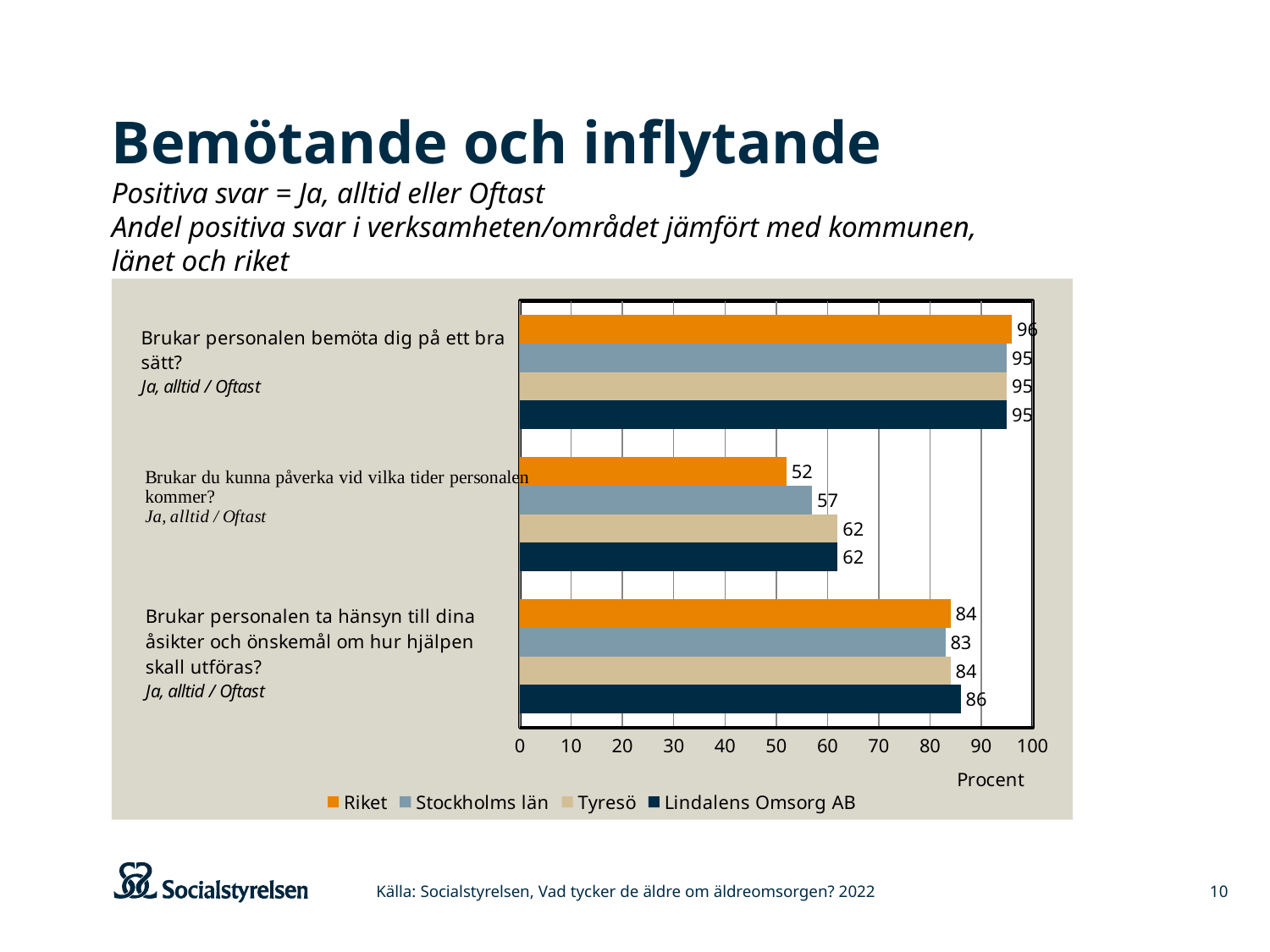
What is the value for Stockholms län on the question 'Brukar personalen bemöta dig på ett bra sätt?' 95 What kind of chart is shown on the slide? Bar chart What is the value for Riket on the question 'Brukar du kunna påverka vid vilka tider personalen kommer?' 52 What is the difference between Lindalens Omsorg AB and Riket on the question 'Brukar du kunna påverka vid vilka tider personalen kommer?' 10 Which series has the lowest value on the question 'Brukar du kunna påverka vid vilka tider personalen kommer?' Riket What is the label on the x axis of the chart? Procent What is the value for Tyresö on the question 'Brukar du kunna påverka vid vilka tider personalen kommer?' 62 Which is larger on the question 'Brukar personalen ta hänsyn till dina åsikter och önskemål om hur hjälpen skall utföras?': Lindalens Omsorg AB or Stockholms län? Lindalens Omsorg AB Is the value for Stockholms län on the question 'Brukar du kunna påverka vid vilka tider personalen kommer?' greater or less than 60? less What is the value for Lindalens Omsorg AB on the question 'Brukar personalen ta hänsyn till dina åsikter och önskemål om hur hjälpen skall utföras?' 86 How many question categories are plotted on the chart? 3 How many series does the legend list? 4